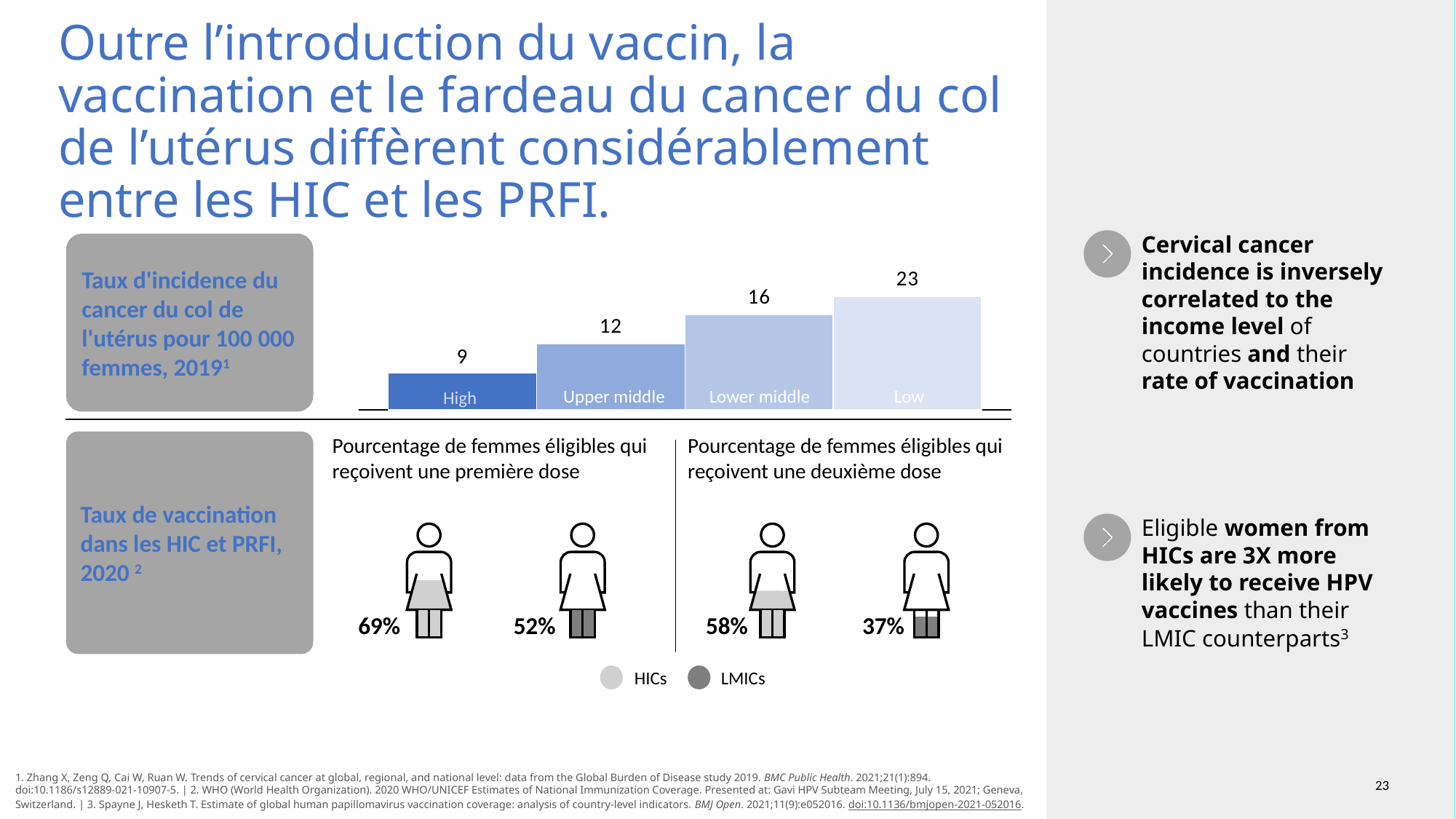
In the bar chart of cervical cancer incidence per 100 000 women, which income group has the highest value? Low In the bar chart of cervical cancer incidence per 100 000 women, do the values rise or fall from High to Low income? rise In the bar chart of cervical cancer incidence per 100 000 women, what is the difference between the Low and High income groups? 14 In the bar chart of cervical cancer incidence per 100 000 women, what is the value for the High income group? 9 In the bar chart of cervical cancer incidence per 100 000 women, which income group has the lowest value? High In the bar chart of cervical cancer incidence per 100 000 women, what is the value for the Lower middle income group? 16 In the vaccination rate graphic, what percentage of eligible women in HICs receive a first dose? 69% How many income groups are shown in the bar chart of cervical cancer incidence per 100 000 women? 4 In the bar chart of cervical cancer incidence per 100 000 women, which is larger: Upper middle or Lower middle? Lower middle What kind of chart shows cervical cancer incidence per 100 000 women? bar chart In the vaccination rate graphic, what percentage of eligible women in LMICs receive a second dose? 37% In the vaccination rate graphic, what is the difference between the first-dose rates for HICs and LMICs? 17%